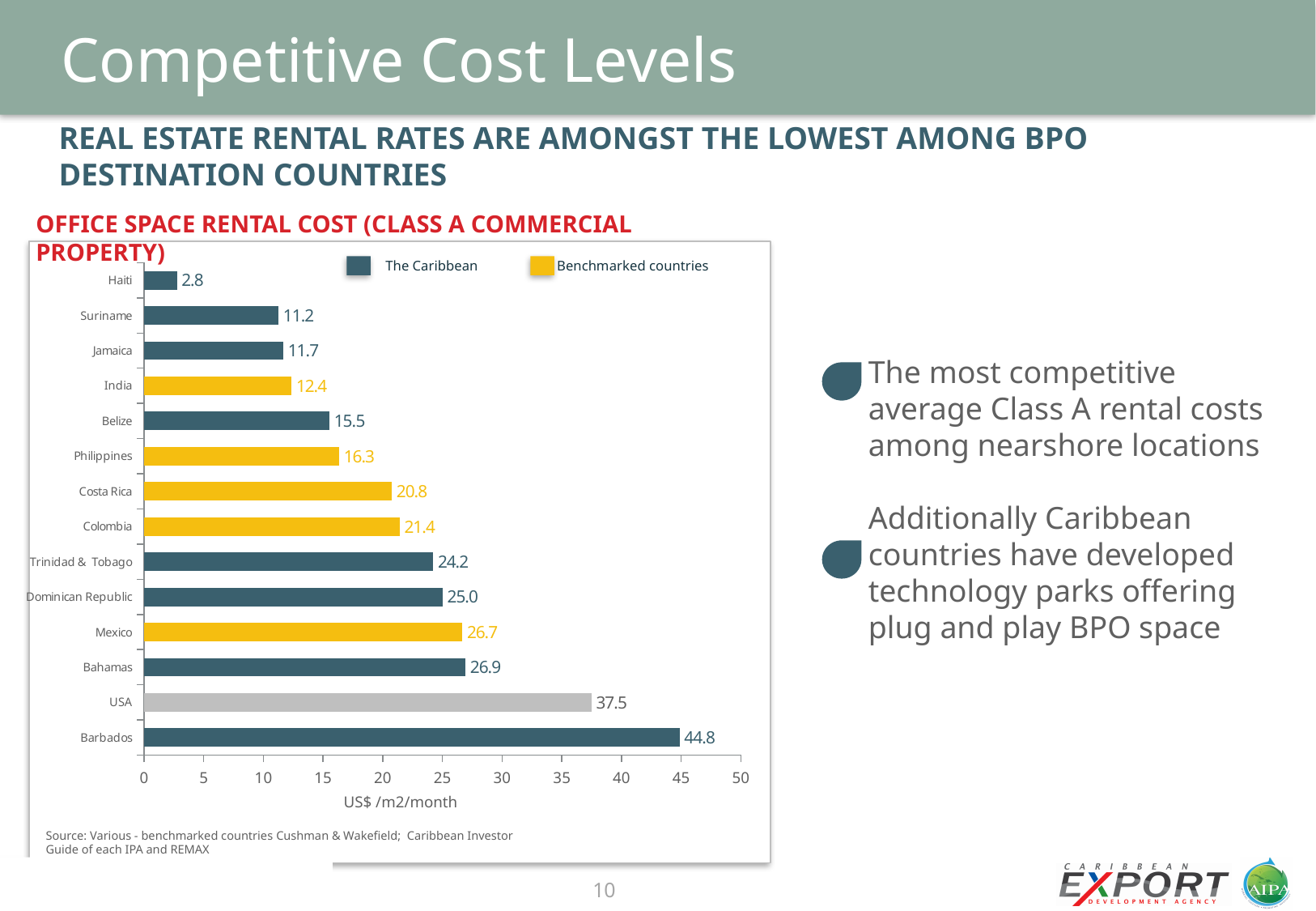
Which has a higher rental cost, Costa Rica or Belize? Costa Rica Is the value for Trinidad & Tobago greater or less than 20? greater What kind of chart is shown on the slide? Bar chart How many countries are shown in the chart? 14 What is the office space rental cost for the USA? 37.5 What unit is shown on the x axis of the chart? US$ /m2/month Which country has the lowest office space rental cost? Haiti Which country has the highest office space rental cost? Barbados How many series does the legend list? 2 What is the office space rental cost for Jamaica? 11.7 What is the difference between the rental cost for Barbados and the USA? 7.3 What is the office space rental cost for Mexico? 26.7